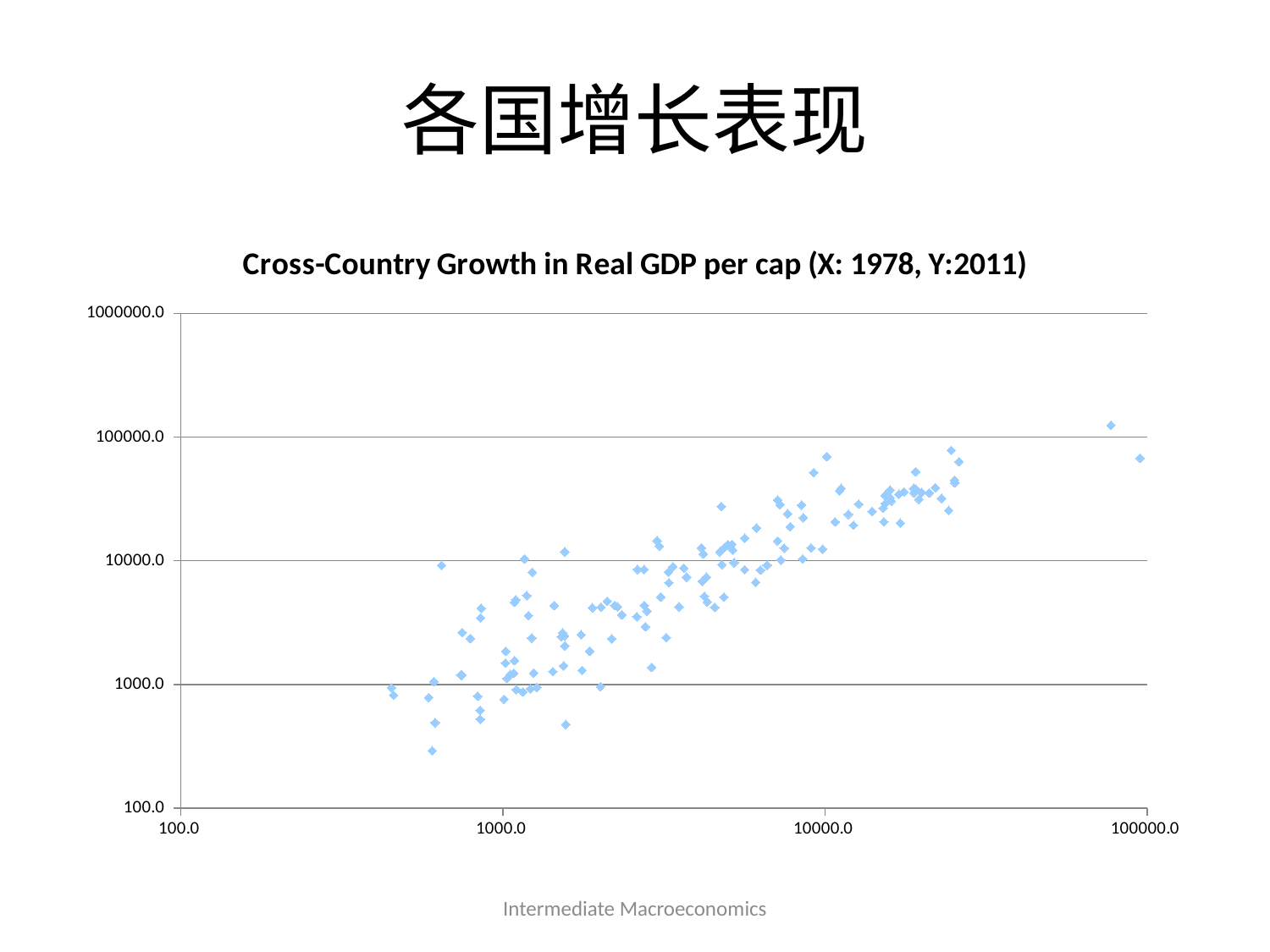
As the x-axis values increase, do the plotted y values generally rise or fall? Rise What is the highest tick label shown on the y axis? 1000000.0 Is the y value of the highest plotted point greater or less than 100000.0? greater Is the y value of the lowest plotted point greater or less than 1000.0? less Is the y value of the rightmost plotted point greater or less than 10000.0? greater What kind of chart is shown on the slide? Scatter chart What is the title of the chart? Cross-Country Growth in Real GDP per cap (X: 1978, Y:2011)